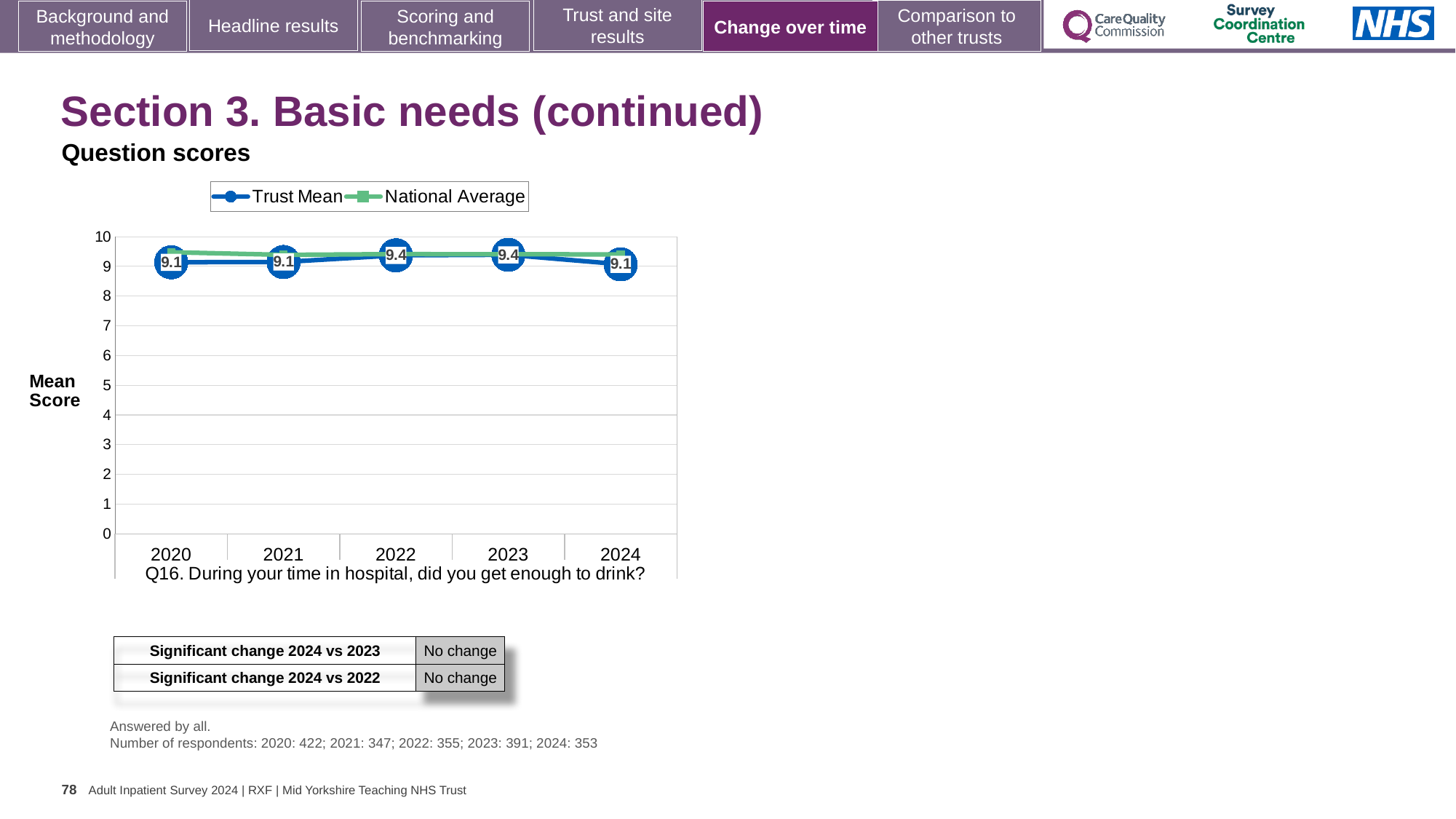
What is the Trust Mean score for 2022? 9.4 What is the difference between the Trust Mean scores for 2022 and 2024? 0.3 Does the Trust Mean score rise or fall from 2023 to 2024? Fall What is the Trust Mean score for 2024? 9.1 What is the Trust Mean score for 2023? 9.4 How many years are plotted on the x axis? 5 Is the National Average value for 2020 greater or less than 9? greater Which year has the larger Trust Mean score, 2021 or 2022? 2022 What kind of chart is shown on the slide? Line chart What question is the chart about, as shown below the x axis? Q16. During your time in hospital, did you get enough to drink? What is the Trust Mean score for 2020? 9.1 How many series does the legend list? 2